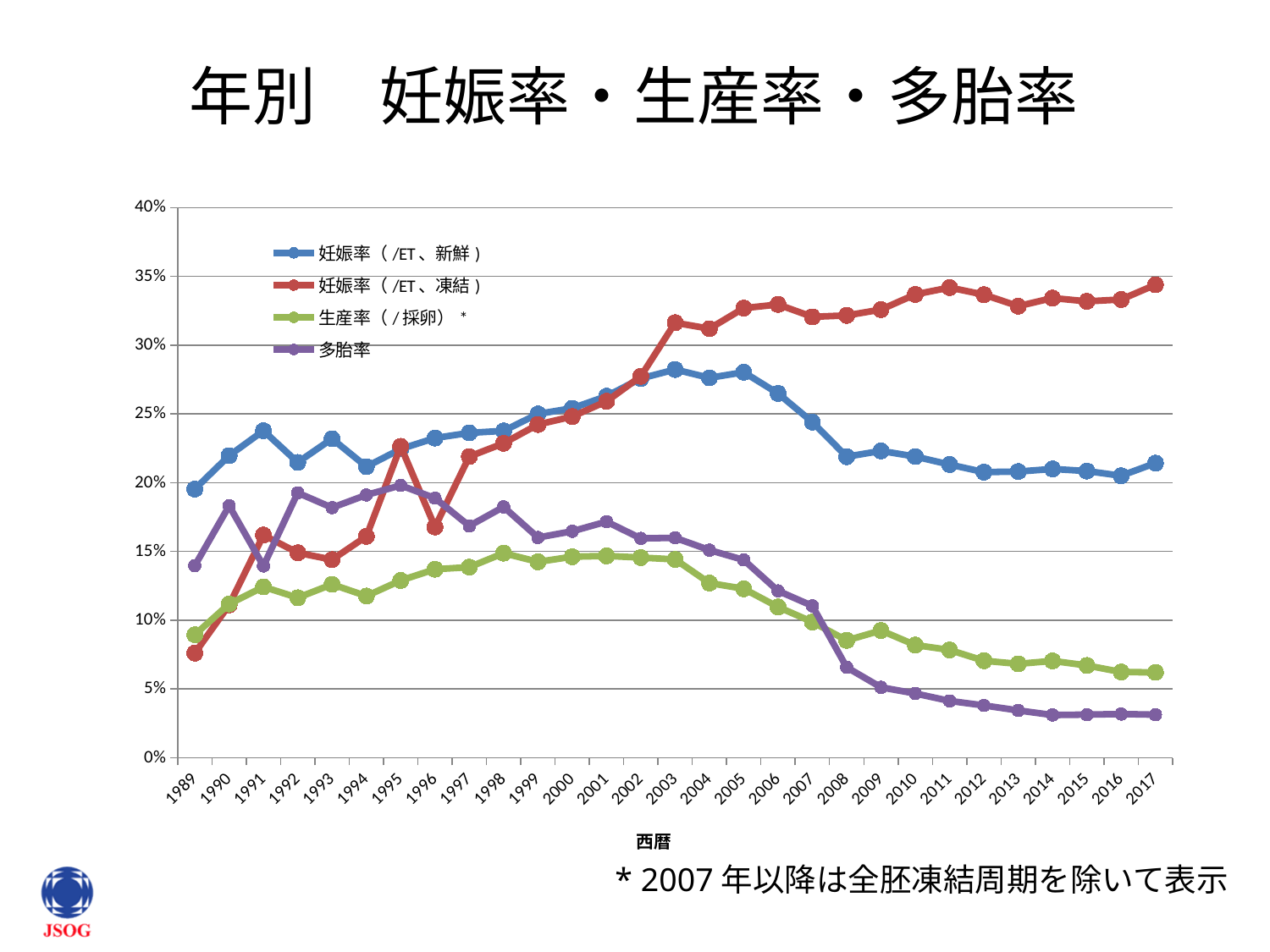
Does 多胎率 rise or fall from 2005 to 2017? fall Is the value for 妊娠率（/ET、凍結） in 2017 greater or less than 30%? greater Is the value for 妊娠率（/ET、凍結） in 1989 greater or less than 10%? less How many series does the legend list? 4 Is the value for 妊娠率（/ET、新鮮） in 2017 greater or less than 25%? less What is the x-axis title of the chart? 西暦 Which series has the highest value in 2017? 妊娠率（/ET、凍結） What kind of chart is shown on the slide? line chart How many years are plotted along the x axis? 29 In 2017, which is larger: 妊娠率（/ET、凍結） or 妊娠率（/ET、新鮮）? 妊娠率（/ET、凍結） In 1989, which is larger: 妊娠率（/ET、新鮮） or 多胎率? 妊娠率（/ET、新鮮）